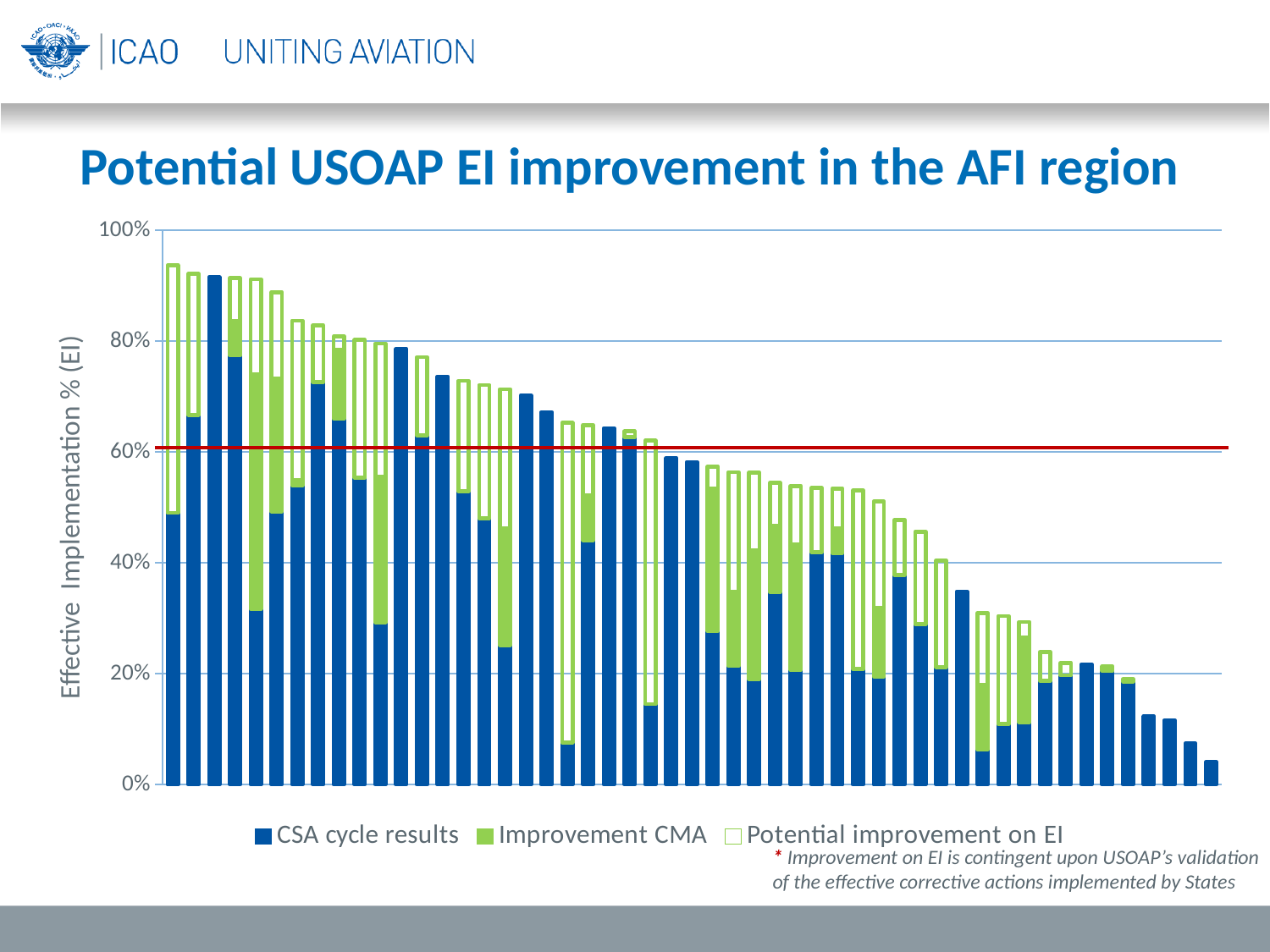
Is the tallest CSA cycle results bar greater or less than 80%? greater What is the label of the vertical axis? Effective Implementation % (EI) Is the total height of the leftmost stacked bar greater or less than 80%? greater Is the CSA cycle results value for the rightmost bar greater or less than 20%? less What kind of chart is shown on the slide? Bar chart What is the title of the chart? Potential USOAP EI improvement in the AFI region Which series is shown in dark blue? CSA cycle results How many series does the legend list? 3 Do the CSA cycle results values rise or fall from left to right along the x axis? Fall Is the CSA cycle results value for the leftmost bar larger or smaller than that of the rightmost bar? Larger